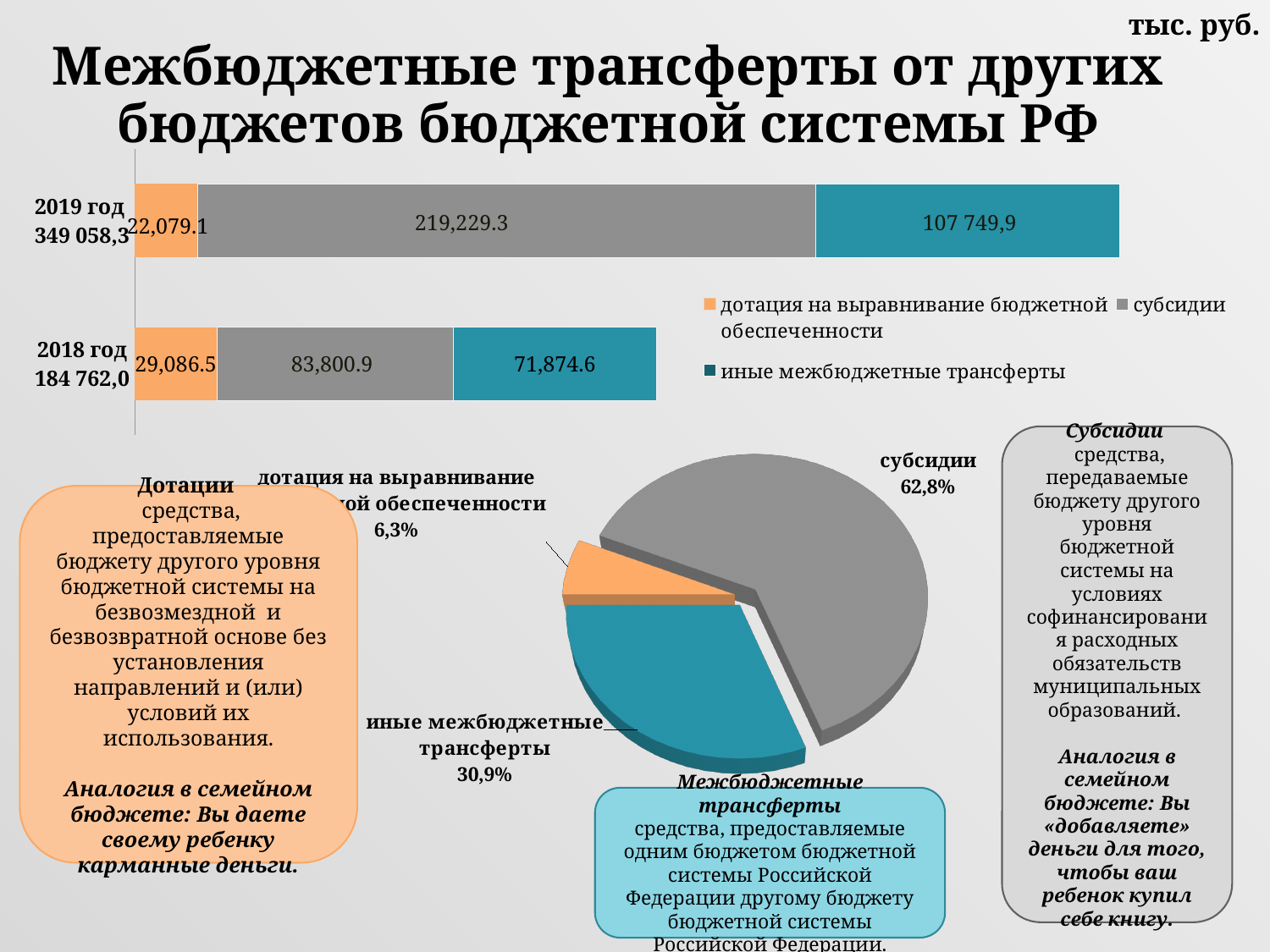
In the pie chart, what share do субсидии have? 62,8% In the stacked bar chart, which year has the larger value for субсидии, 2018 год or 2019 год? 2019 год In the stacked bar chart, what is the value of дотация на выравнивание бюджетной обеспеченности for 2019 год? 22,079.1 How many series does the legend of the stacked bar chart list? 3 In the pie chart, what share do иные межбюджетные трансферты have? 30,9% In the stacked bar chart, what is the value of субсидии for 2019 год? 219,229.3 In the pie chart, which slice is the smallest? дотация на выравнивание бюджетной обеспеченности In the stacked bar chart, which series has the smallest value in 2018 год? дотация на выравнивание бюджетной обеспеченности In the stacked bar chart, what is the value of иные межбюджетные трансферты for 2018 год? 71,874.6 What kind of chart is the chart at the top of the slide showing 2019 год and 2018 год? bar chart In the stacked bar chart, what is the total shown for 2019 год? 349 058,3 In the stacked bar chart, what is the total shown for 2018 год? 184 762,0